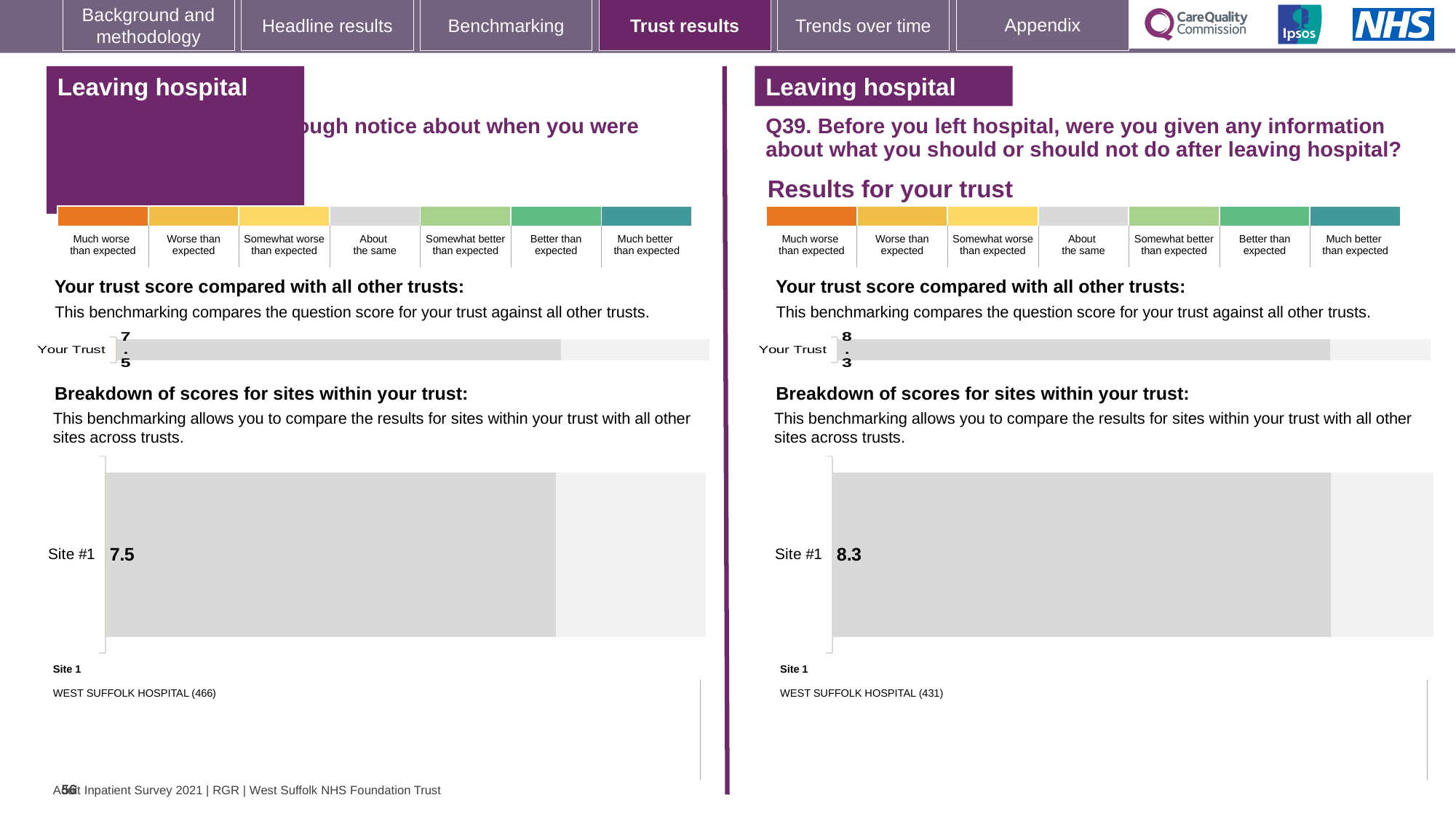
On the left-hand chart, what is the score shown for Your Trust? 7.5 Which is larger: the Site #1 score on the left-hand chart or the Site #1 score on the right-hand chart for Q39? Right-hand chart (Q39) On the right-hand chart for Q39, what is the score shown for Your Trust? 8.3 On the left-hand chart, what is the score shown for Site #1? 7.5 On the left-hand side, which site is listed as Site 1? WEST SUFFOLK HOSPITAL (466) What kind of chart is used to show the Site #1 score on the right-hand side for Q39? Bar chart On the right-hand chart for Q39, what is the score shown for Site #1? 8.3 How many sites are shown in the breakdown of scores chart on the right-hand side for Q39? 1 What is the difference between the Site #1 score on the right-hand chart for Q39 and the Site #1 score on the left-hand chart? 0.8 How many sites are shown in the breakdown of scores chart on the left-hand side? 1 On the right-hand side for Q39, which site is listed as Site 1? WEST SUFFOLK HOSPITAL (431)